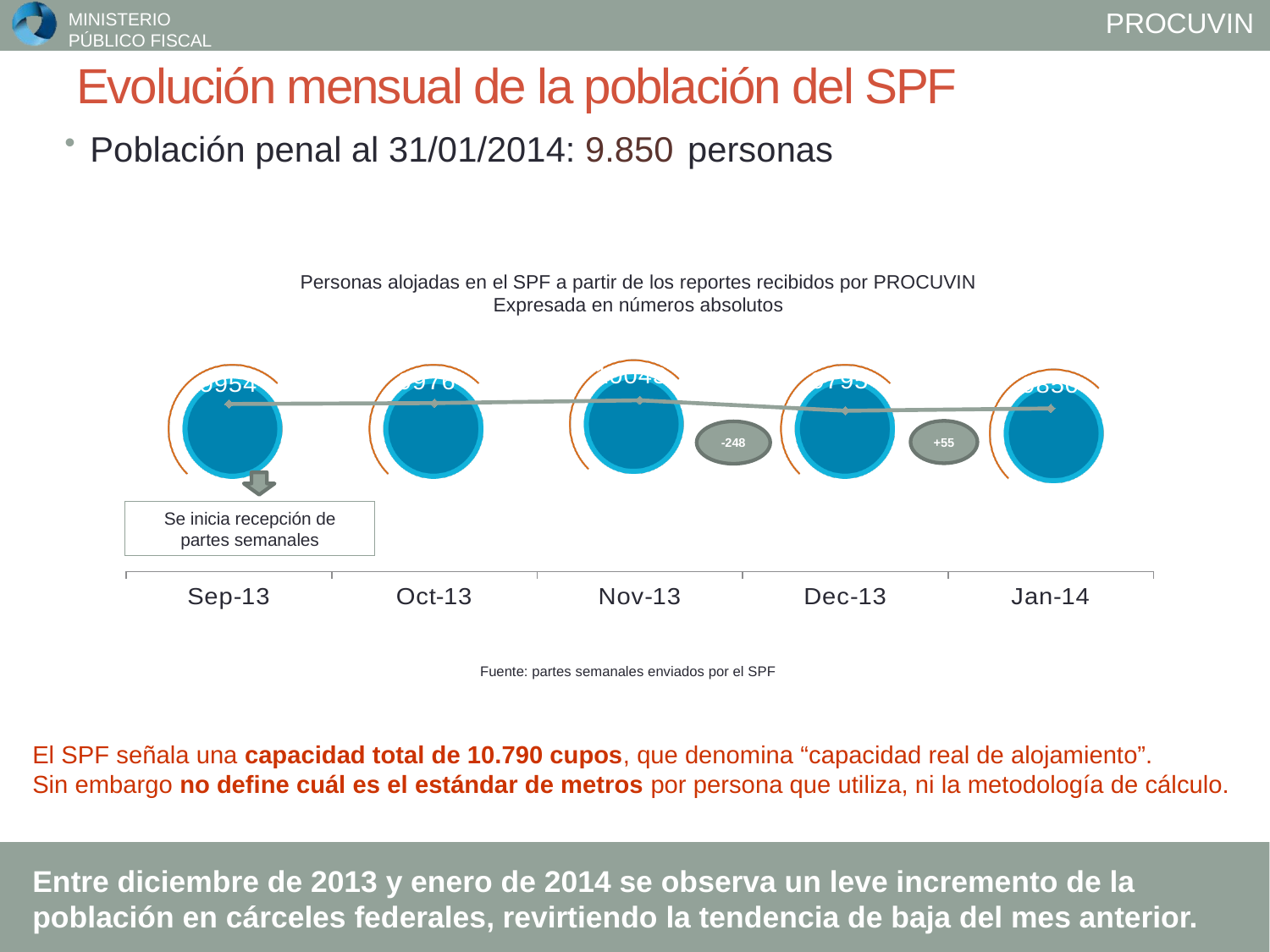
What kind of chart is shown on the slide? line chart Which month shows the lowest population on the chart? Dec-13 Which month has the higher population, Nov-13 or Dec-13? Nov-13 What is the first month shown on the x axis of the chart? Sep-13 What change in population is annotated between Nov-13 and Dec-13? -248 How many months (data points) are plotted on the chart? 5 Does the population rise or fall from Dec-13 to Jan-14? rise Does the population rise or fall from Nov-13 to Dec-13? fall What change in population is annotated between Dec-13 and Jan-14? +55 Which month has the higher population, Dec-13 or Jan-14? Jan-14 According to the slide, what is the penal population at 31/01/2014 (Jan-14)? 9.850 What is the last month shown on the x axis of the chart? Jan-14